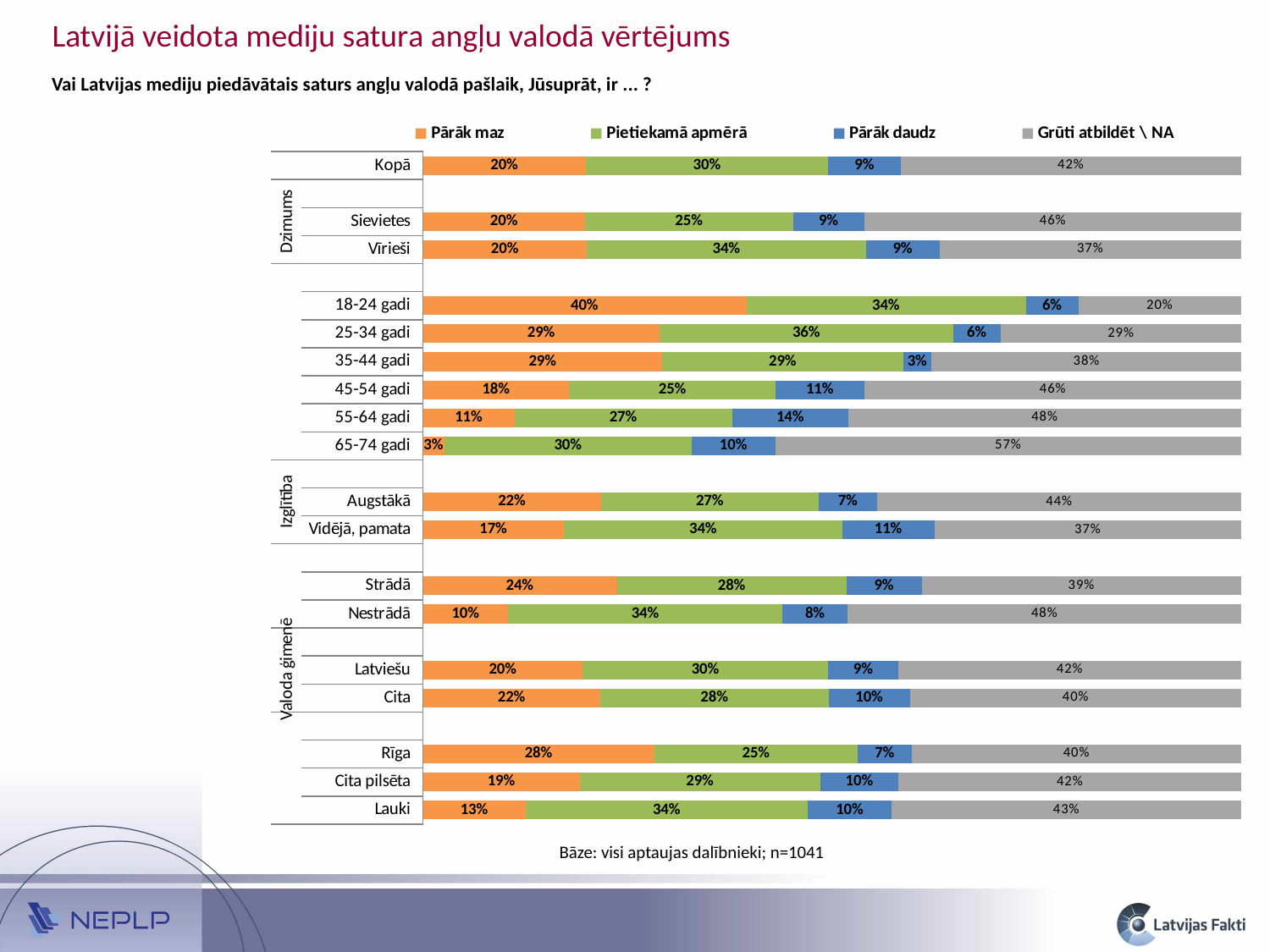
Which age group has the highest "Pārāk maz" value? 18-24 gadi What is the difference between the "Pārāk maz" values for "Rīga" and "Lauki"? 15% What is the base (n) stated below the chart? n=1041 What is the "Grūti atbildēt \ NA" value for "65-74 gadi"? 57% How many series does the legend list? 4 Which has a larger "Pietiekamā apmērā" value, "Sievietes" or "Vīrieši"? Vīrieši What is the "Pārāk daudz" value for "55-64 gadi"? 14% What is the "Pārāk maz" value for "Nestrādā"? 10% What is the "Pārāk maz" value for the "Kopā" bar? 20% What is the "Pietiekamā apmērā" value for "25-34 gadi"? 36% Which age group has the lowest "Pārāk maz" value? 65-74 gadi What kind of chart is shown on the slide? Stacked bar chart